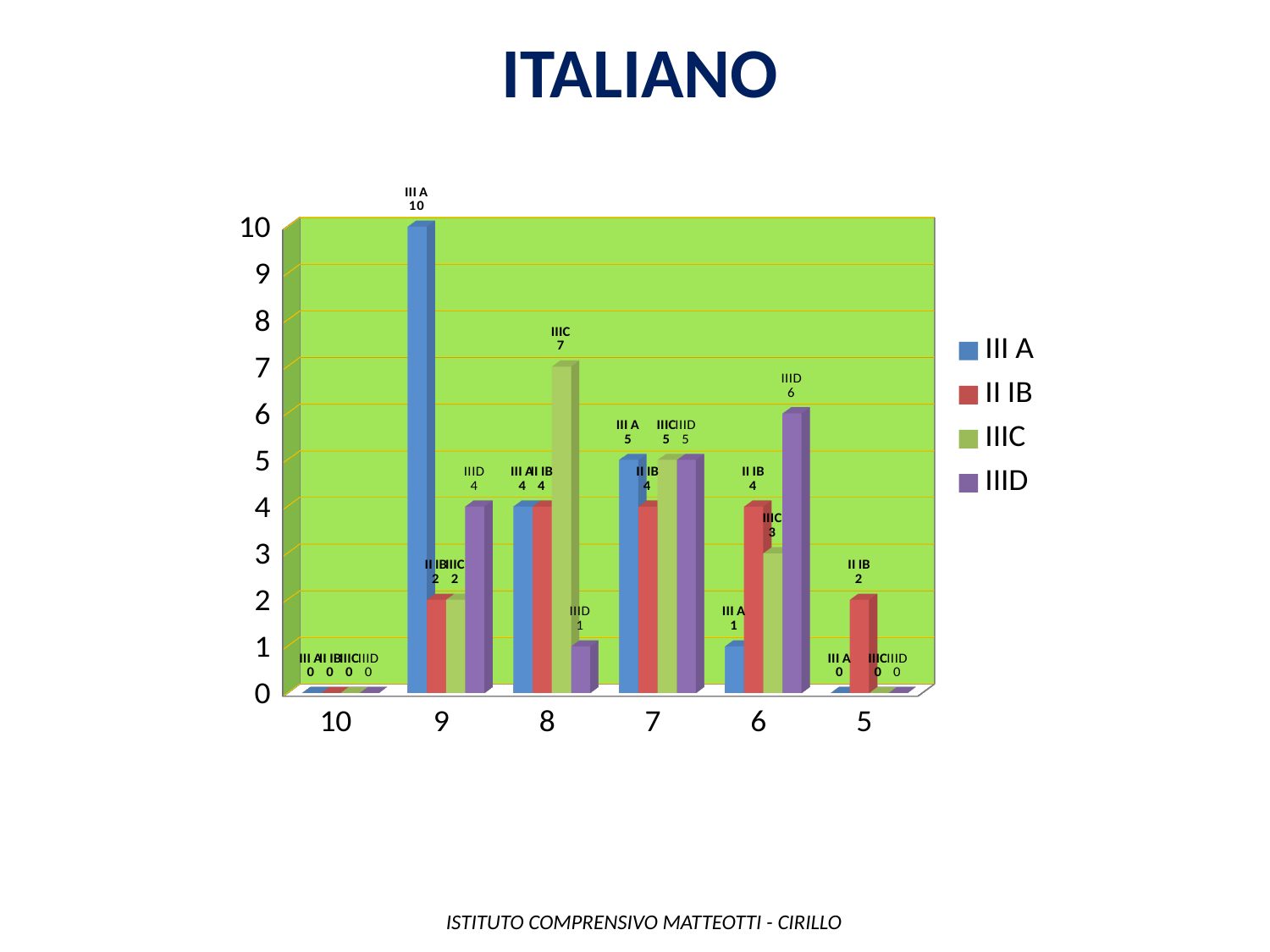
What is the value for II IB at category 5? 2 What is the value for IIID at category 6? 6 How many series does the legend list? 4 What is the title of the chart? ITALIANO What kind of chart is shown on the slide? bar chart How many categories are shown on the x axis? 6 At category 6, which is larger: the value for II IB or the value for IIIC? II IB What is the value for III A at category 9? 10 What is the difference between the IIIC value and the IIID value at category 8? 6 Which series has the lowest value at category 8? IIID Which category has the highest value for III A? 9 What is the value for IIIC at category 8? 7